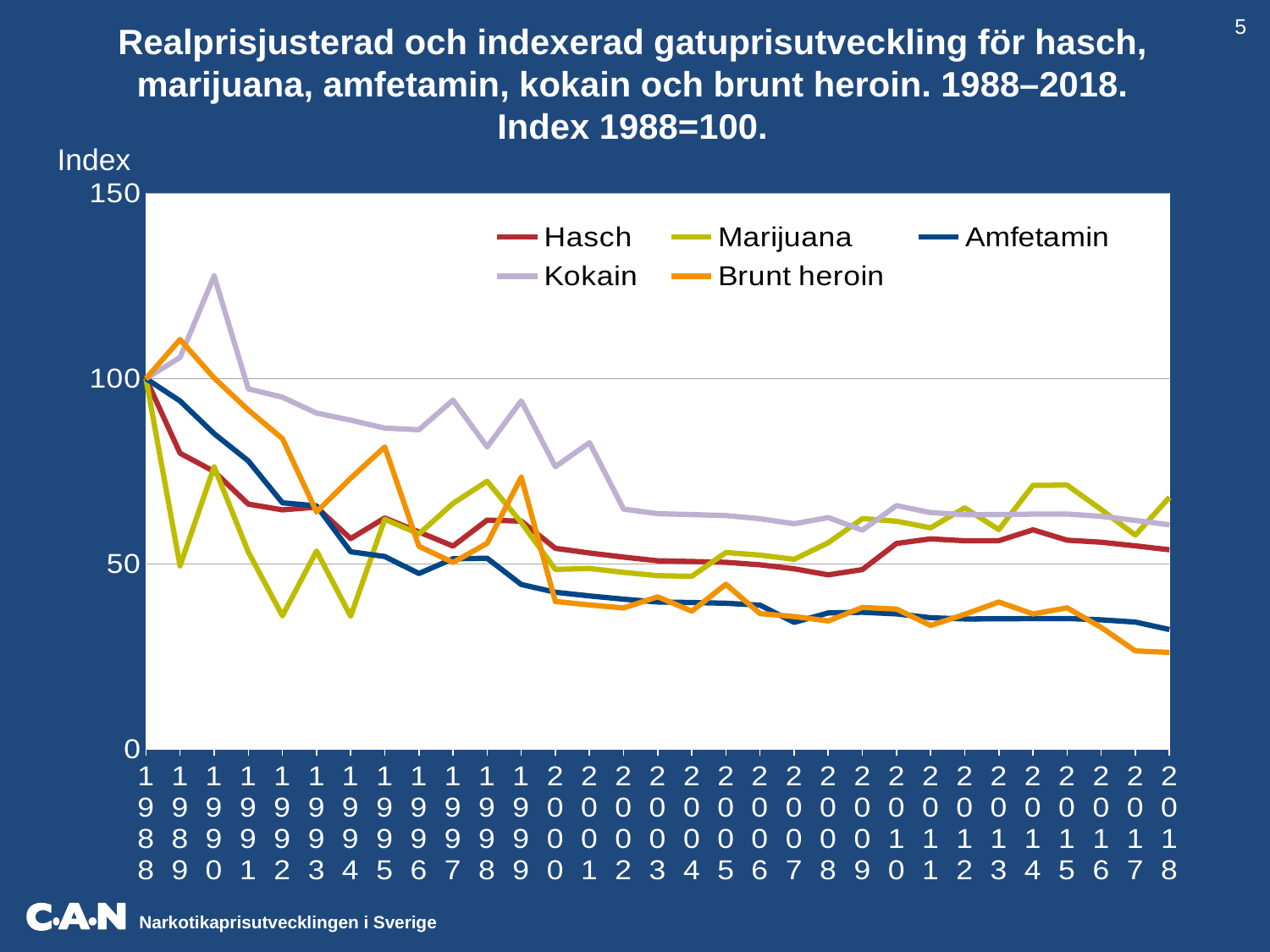
What is the index value for Hasch in 1988? 100 Does the Amfetamin line generally rise or fall from 1988 to 2018? fall Which series has the highest value in 1990? Kokain How many years are plotted along the x axis? 31 What kind of chart is shown on the slide? line chart Is the value for Brunt heroin in 2018 greater or less than 50? less How many series does the legend list? 5 Is the value for Kokain in 1990 greater or less than 100? greater Which series has the lowest value in 1992? Marijuana Is the value for Marijuana in 2014 greater or less than 50? greater Which series is drawn in orange in the legend? Brunt heroin Which is larger in 2018, the value for Marijuana or the value for Amfetamin? Marijuana